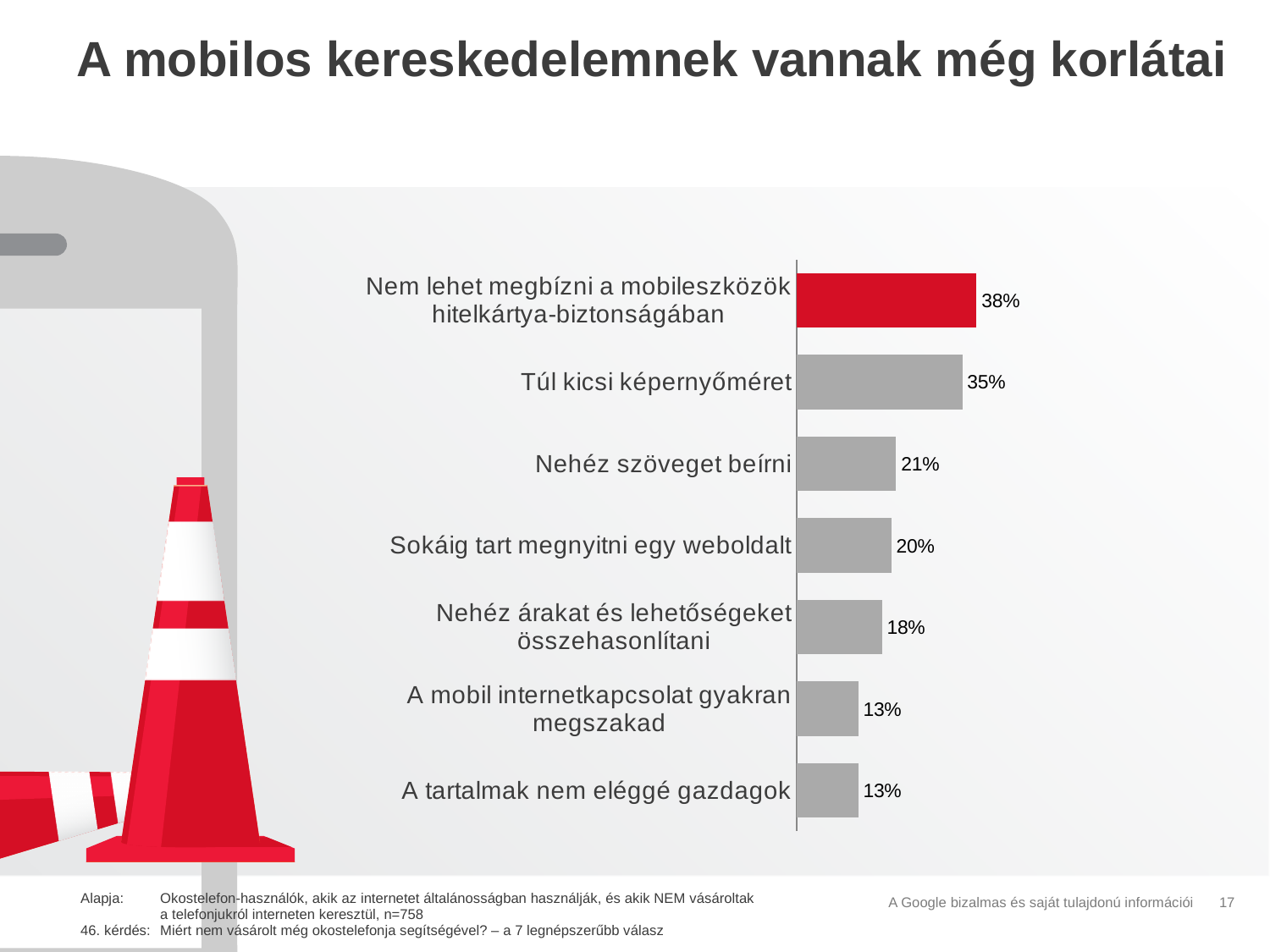
What is the value for "Sokáig tart megnyitni egy weboldalt"? 20% What is the difference between "Nehéz szöveget beírni" and "A tartalmak nem eléggé gazdagok"? 8% Which category has the highest value? Nem lehet megbízni a mobileszközök hitelkártya-biztonságában How many categories are shown in the chart? 7 What is the value for "Túl kicsi képernyőméret"? 35% What is the title of the slide? A mobilos kereskedelemnek vannak még korlátai What is the value for "Nehéz árakat és lehetőségeket összehasonlítani"? 18% Which is larger: "Nehéz szöveget beírni" or "Nehéz árakat és lehetőségeket összehasonlítani"? Nehéz szöveget beírni Which bar is coloured red rather than grey? Nem lehet megbízni a mobileszközök hitelkártya-biztonságában What kind of chart is shown on the slide? Bar chart What is the difference between "Nem lehet megbízni a mobileszközök hitelkártya-biztonságában" and "Túl kicsi képernyőméret"? 3% What is the value for "Nehéz szöveget beírni"? 21%